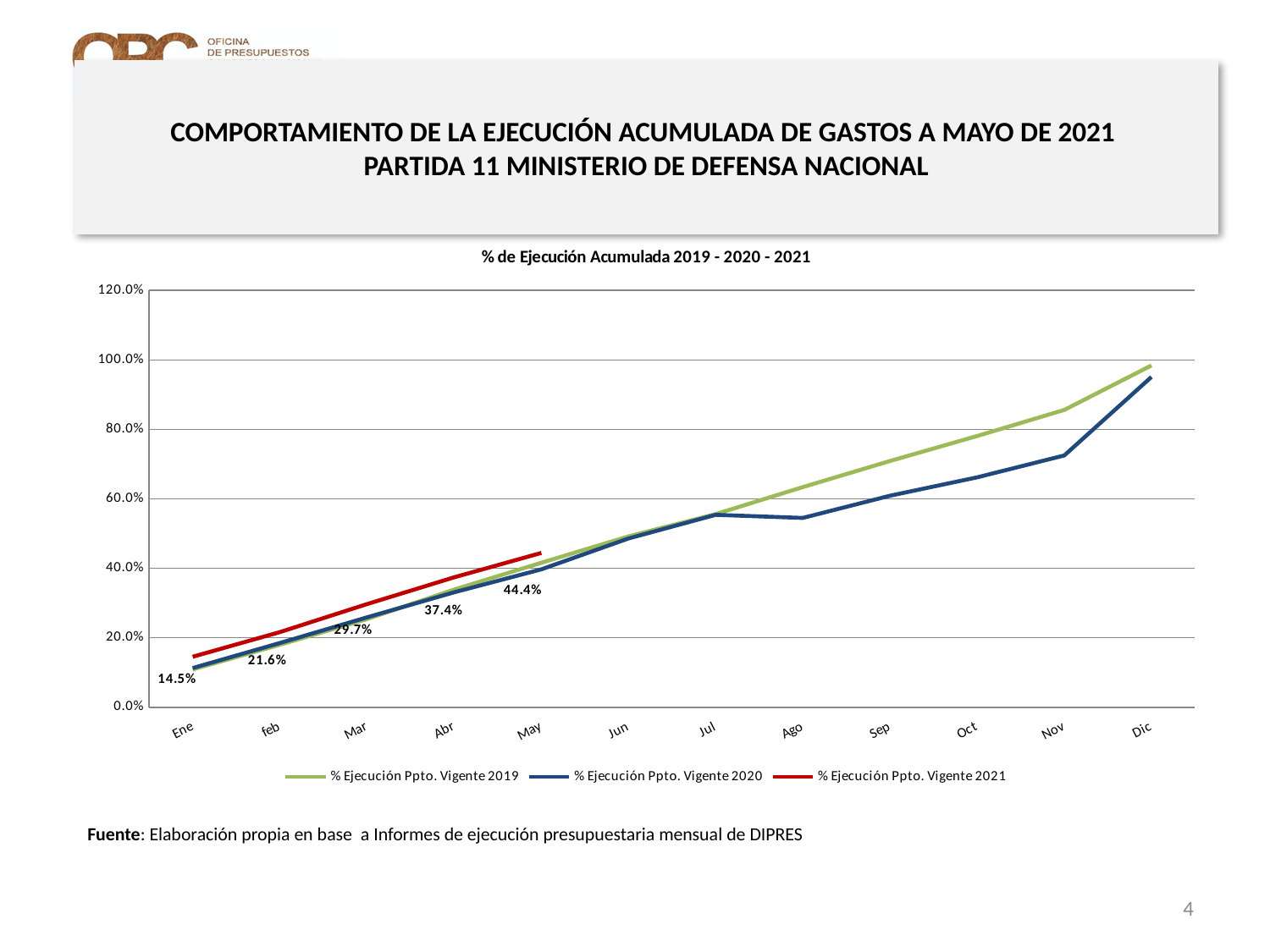
In Nov, which series is higher: % Ejecución Ppto. Vigente 2019 or % Ejecución Ppto. Vigente 2020? % Ejecución Ppto. Vigente 2019 How many series does the legend list? 3 What is the value for % Ejecución Ppto. Vigente 2021 in May? 44.4% Is the value for % Ejecución Ppto. Vigente 2019 in Dic greater or less than 80.0%? greater What is the value for % Ejecución Ppto. Vigente 2021 in Ene? 14.5% What kind of chart is shown on the slide? Line chart By how many percentage points did % Ejecución Ppto. Vigente 2021 increase from Ene to May? 29.9 percentage points Does the % Ejecución Ppto. Vigente 2019 line rise or fall from Ene to Dic? Rise What is the difference between the Abr and Mar values for % Ejecución Ppto. Vigente 2021? 7.7 percentage points What is the value for % Ejecución Ppto. Vigente 2021 in Mar? 29.7% Is the value for % Ejecución Ppto. Vigente 2020 in Ago greater or less than 60.0%? less How many months are shown along the x axis? 12